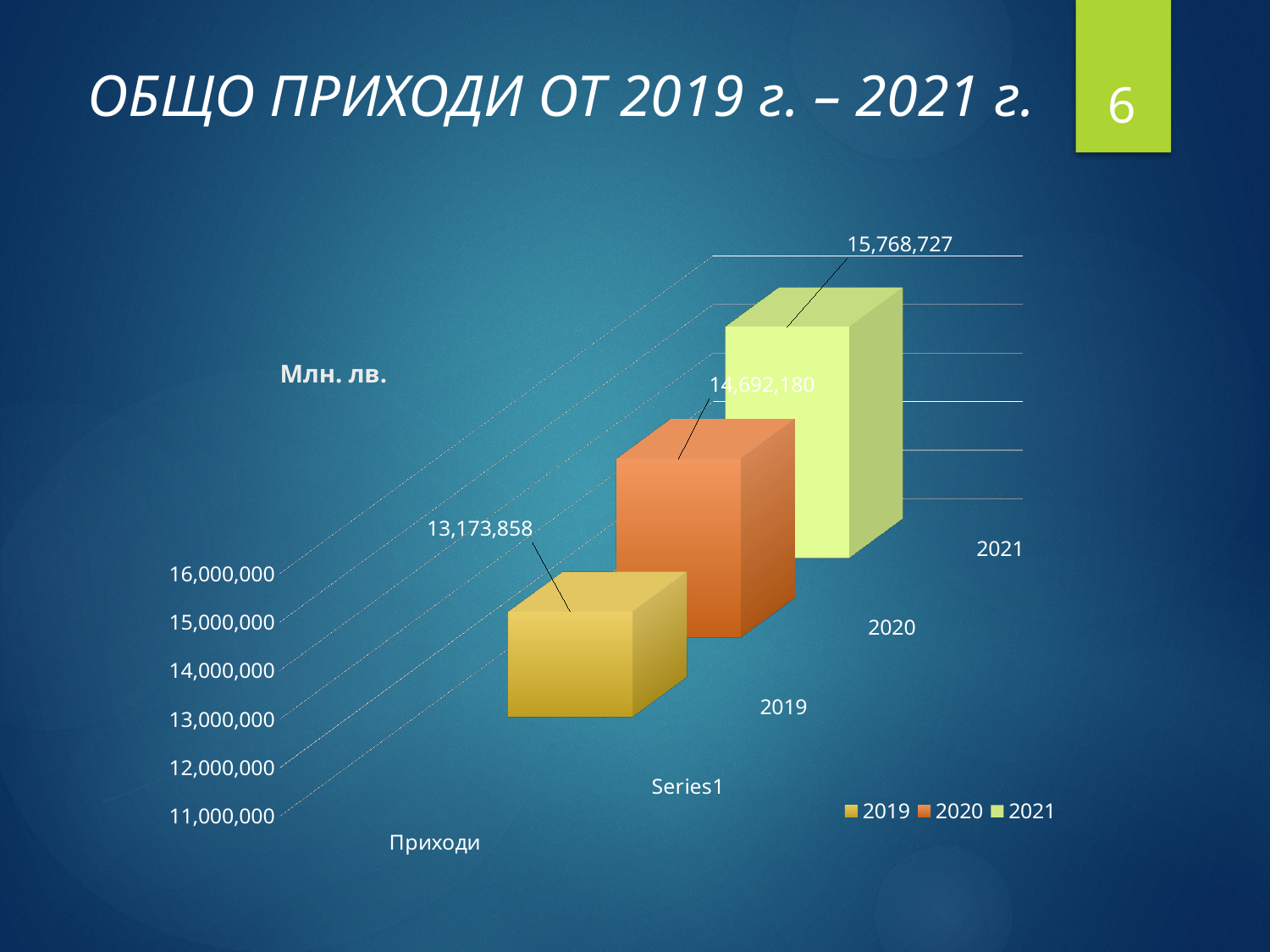
Which year has the lowest value? 2019 Do the values rise or fall from 2019 to 2021? Rise What kind of chart is shown on the slide? Bar chart Which year has the highest value? 2021 What is the value shown for 2019? 13,173,858 What is the difference between the values for 2021 and 2020? 1,076,547 What is the title of the slide? ОБЩО ПРИХОДИ ОТ 2019 г. – 2021 г. What is the value shown for 2020? 14,692,180 What is the value shown for 2021? 15,768,727 Which is larger, the value for 2020 or the value for 2021? 2021 What is the difference between the values for 2020 and 2019? 1,518,322 How many series does the legend list? 3